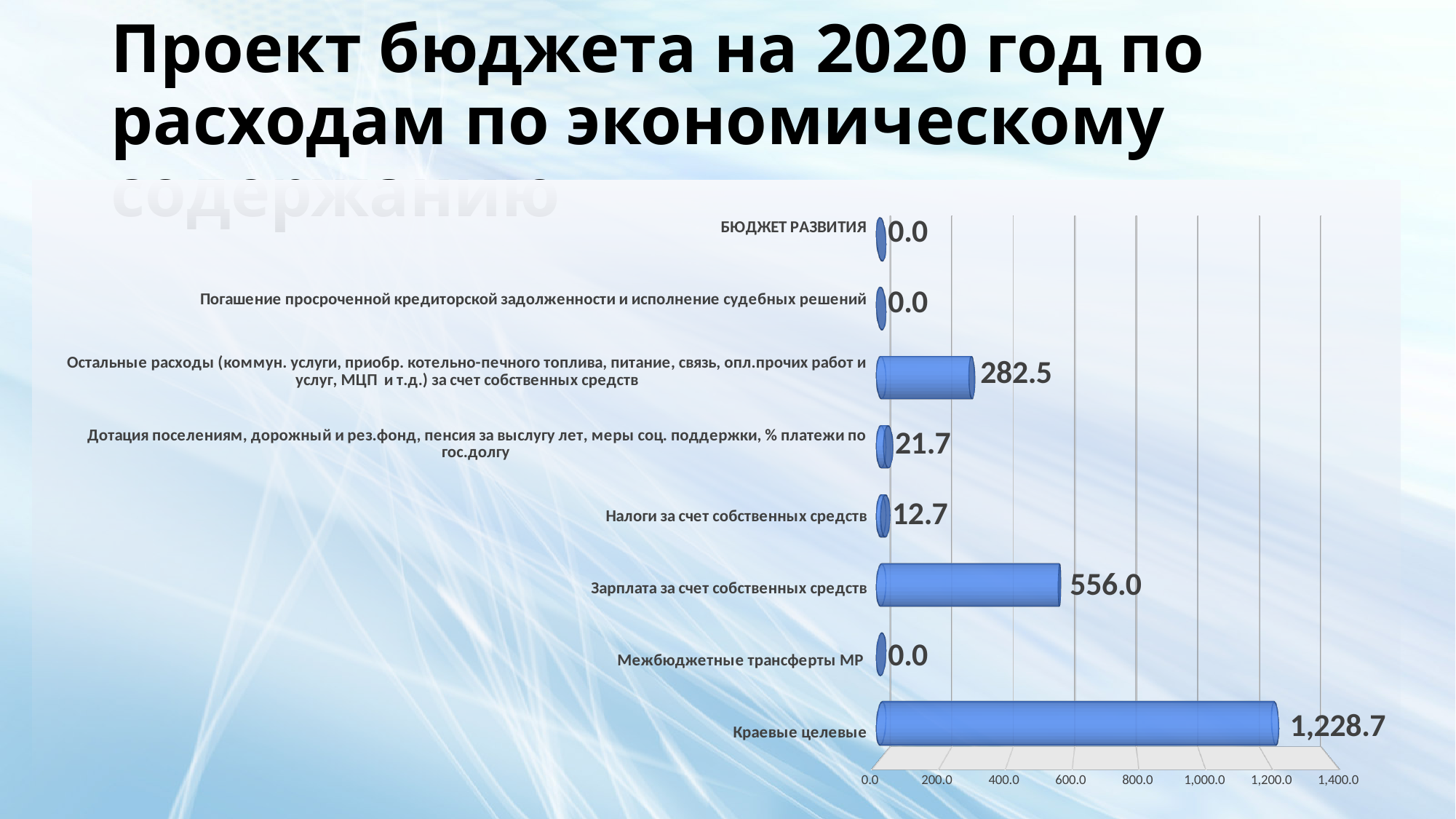
What is the value for Зарплата за счет собственных средств? 556.0 Is the value for Краевые целевые greater or less than 1,000.0? greater What is the value for Налоги за счет собственных средств? 12.7 Which is larger: the value for Зарплата за счет собственных средств or the value for Остальные расходы (коммун. услуги, приобр. котельно-печного топлива, питание, связь, опл.прочих работ и услуг, МЦП и т.д.) за счет собственных средств? Зарплата за счет собственных средств How many categories are shown in the chart? 8 How many categories have a value of 0.0? 3 What is the difference between the values for Остальные расходы (коммун. услуги, приобр. котельно-печного топлива, питание, связь, опл.прочих работ и услуг, МЦП и т.д.) за счет собственных средств and Дотация поселениям, дорожный и рез.фонд, пенсия за выслугу лет, меры соц. поддержки, % платежи по гос.долгу? 260.8 What is the value for Краевые целевые? 1,228.7 Which category has the highest value? Краевые целевые What is the difference between the values for Краевые целевые and Зарплата за счет собственных средств? 672.7 What kind of chart is shown on the slide? Bar chart What is the value for Межбюджетные трансферты МР? 0.0